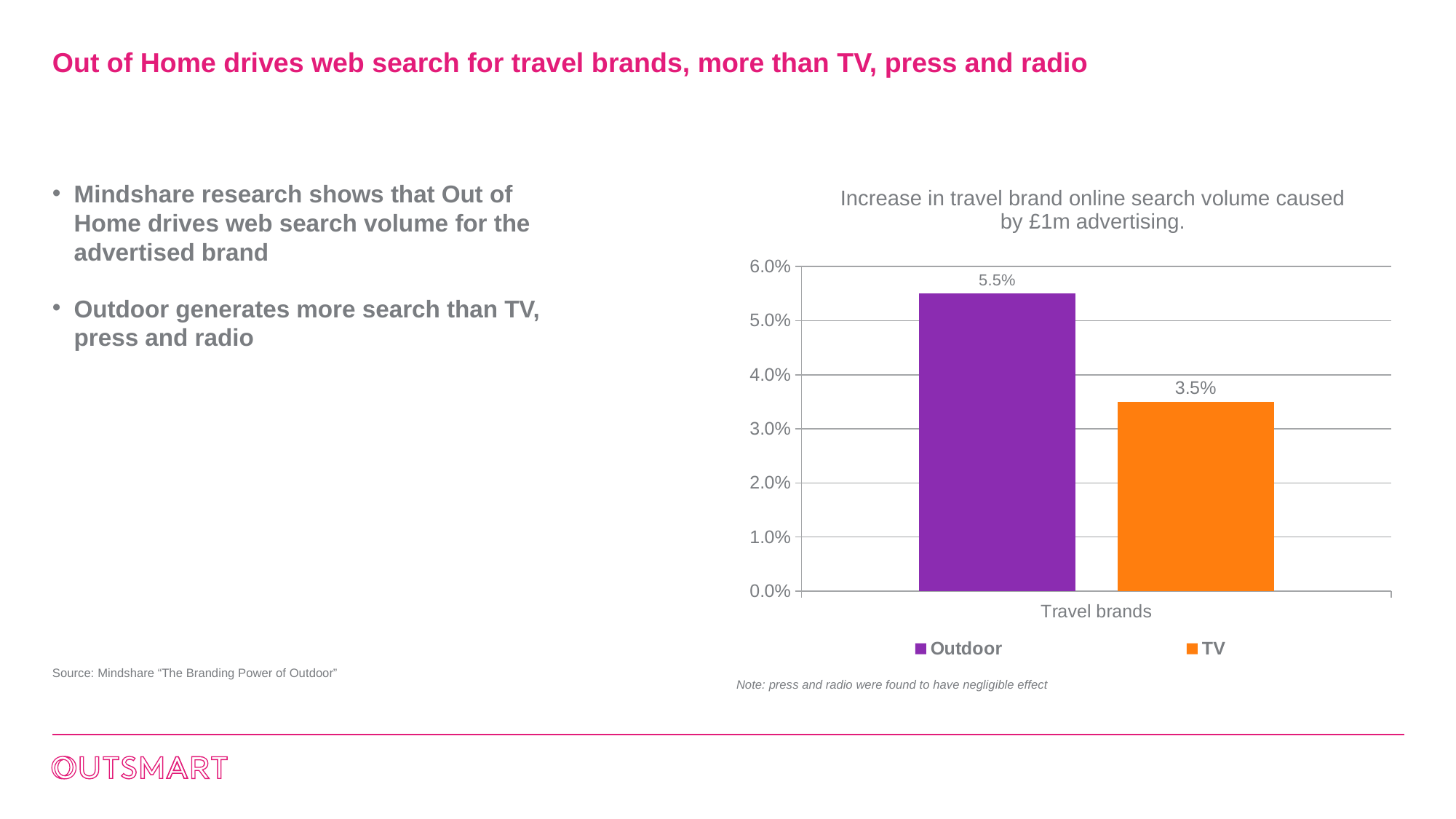
What is the value for Outdoor in the chart? 5.5% What colour is the Outdoor bar in the chart? Purple Which series has the highest value in the chart? Outdoor Which is larger, the value for Outdoor or the value for TV? Outdoor Is the value for TV greater or less than 4.0%? less What is the difference between the Outdoor and TV values? 2.0% How many series does the legend list? 2 Is the value for Outdoor greater or less than 5.0%? greater What kind of chart is shown on the slide? Bar chart What is the title of the chart? Increase in travel brand online search volume caused by £1m advertising. What is the value for TV in the chart? 3.5% Which series has the lowest value in the chart? TV